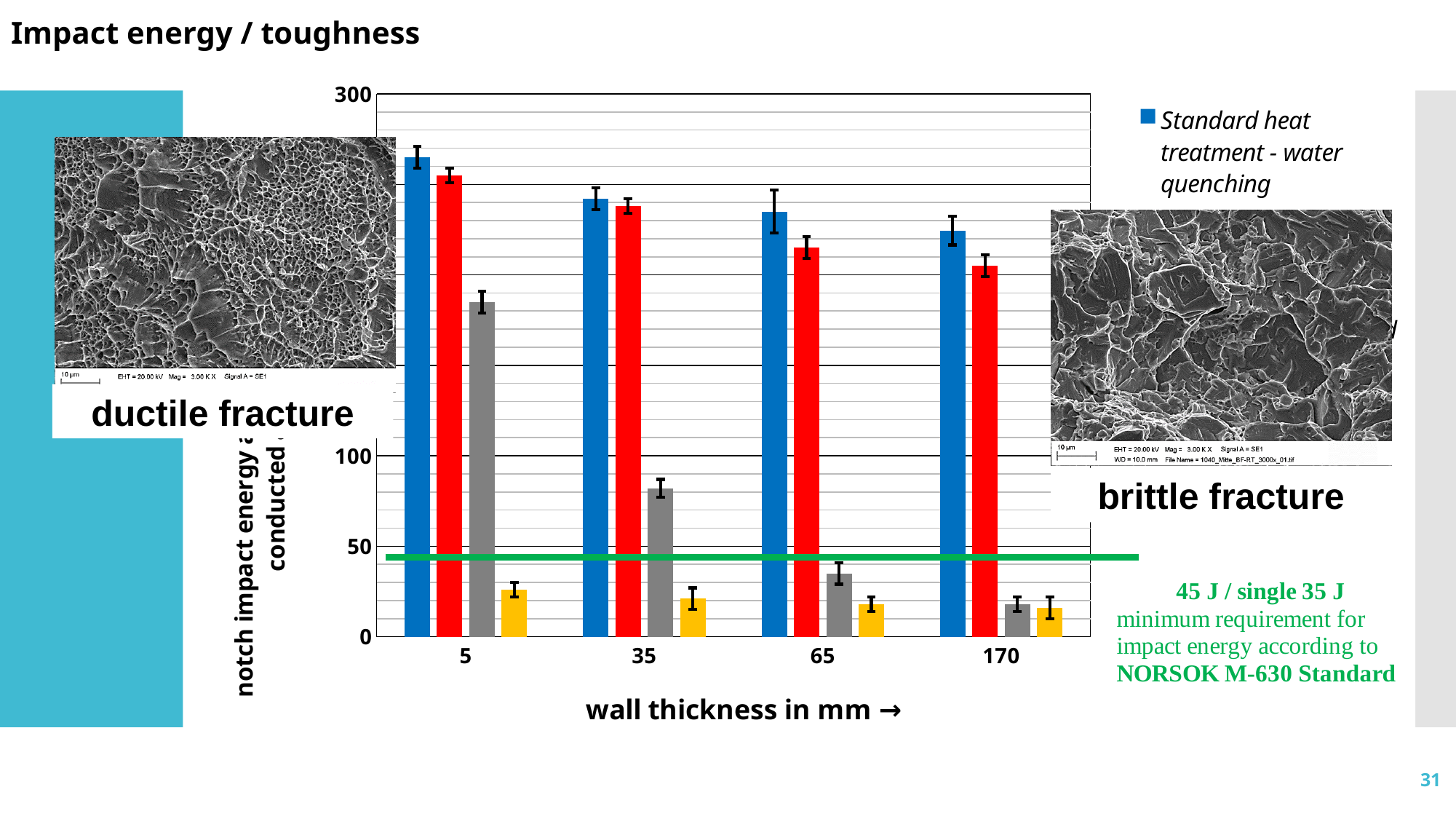
How many wall thickness categories are shown on the x axis? 4 Is the value of the yellow bar at wall thickness 5 greater or less than 50? less Which series does the blue bar represent according to the legend? Standard heat treatment - water quenching At which wall thickness is the gray bar highest? 5 Is the value of the gray bar at wall thickness 5 greater or less than 100? greater What is the x-axis title of the chart? wall thickness in mm → Is the value of the gray bar at wall thickness 65 greater or less than 50? less What kind of chart is shown on the slide? bar chart At wall thickness 5, which is larger: the blue bar or the gray bar? the blue bar At which wall thickness is the blue bar (Standard heat treatment - water quenching) highest? 5 Do the gray bars rise or fall as wall thickness increases from 5 to 170? fall